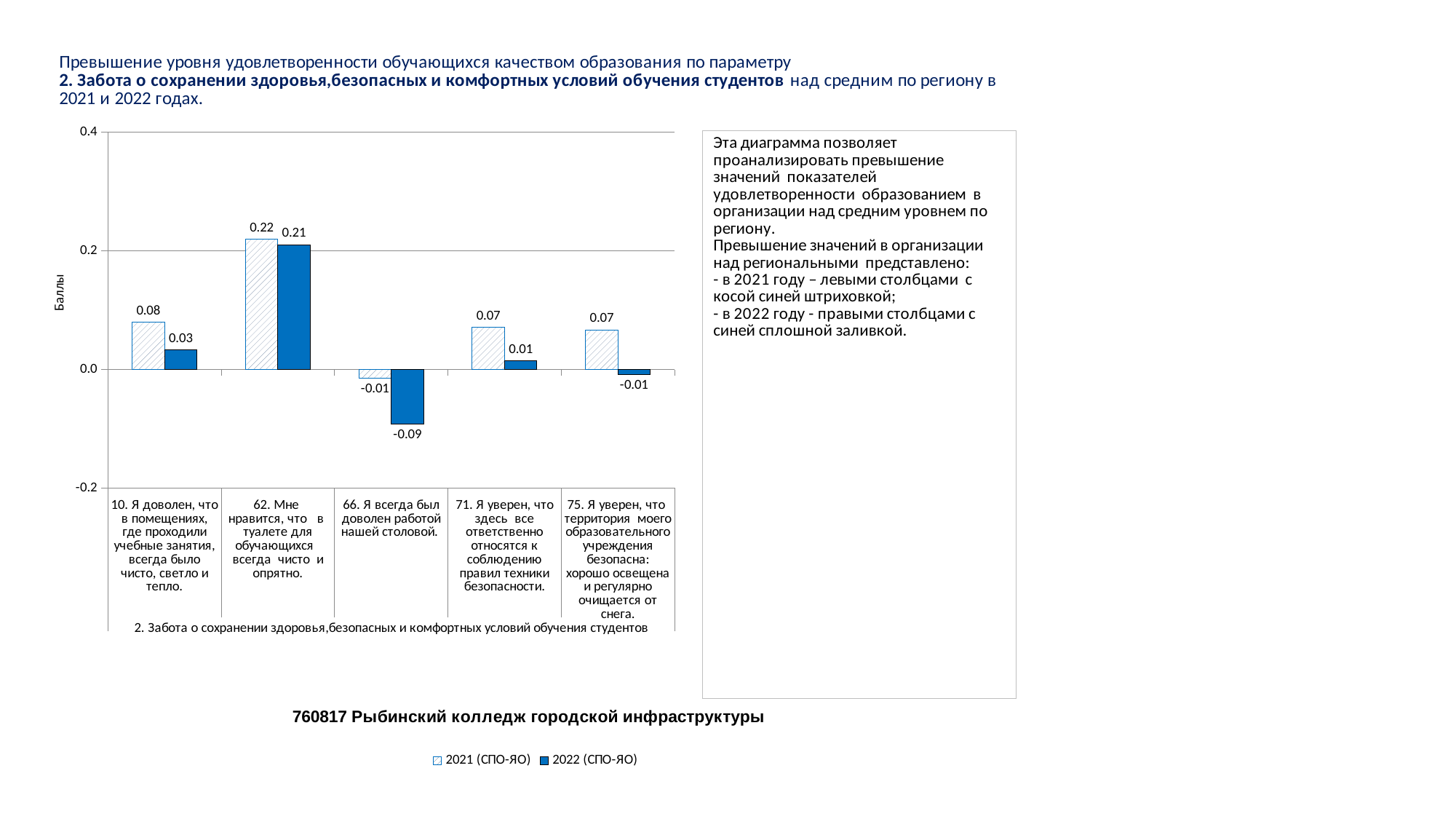
Какое значение у серии 2022 (СПО-ЯО) для категории «75. Я уверен, что территория моего образовательного учреждения безопасна: хорошо освещена и регулярно очищается от снега.»? -0.01 Какая серия имеет большее значение в категории «71. Я уверен, что здесь все ответственно относятся к соблюдению правил техники безопасности.»: 2021 (СПО-ЯО) или 2022 (СПО-ЯО)? 2021 (СПО-ЯО) Какая подпись у вертикальной оси диаграммы? Баллы Какого типа эта диаграмма? Столбчатая (bar chart) Какое значение у серии 2021 (СПО-ЯО) для категории «62. Мне нравится, что в туалете для обучающихся всегда чисто и опрятно.»? 0.22 В какой категории значение серии 2021 (СПО-ЯО) наибольшее? 62. Мне нравится, что в туалете для обучающихся всегда чисто и опрятно. Сколько серий указано в легенде диаграммы? 2 Сколько категорий показано на диаграмме? 5 На сколько значение 2021 (СПО-ЯО) больше значения 2022 (СПО-ЯО) в категории «10. Я довлен, что в помещениях, где проходили учебные занятия, всегда было чисто, светло и тепло.»? 0.05 Какое значение у серии 2022 (СПО-ЯО) для категории «66. Я всегда был доволен работой нашей столовой.»? -0.09 В какой категории значение серии 2022 (СПО-ЯО) наименьшее? 66. Я всегда был доволен работой нашей столовой. Значение серии 2022 (СПО-ЯО) в категории «62. Мне нравится, что в туалете для обучающихся всегда чисто и опрятно.» больше или меньше 0.2? больше